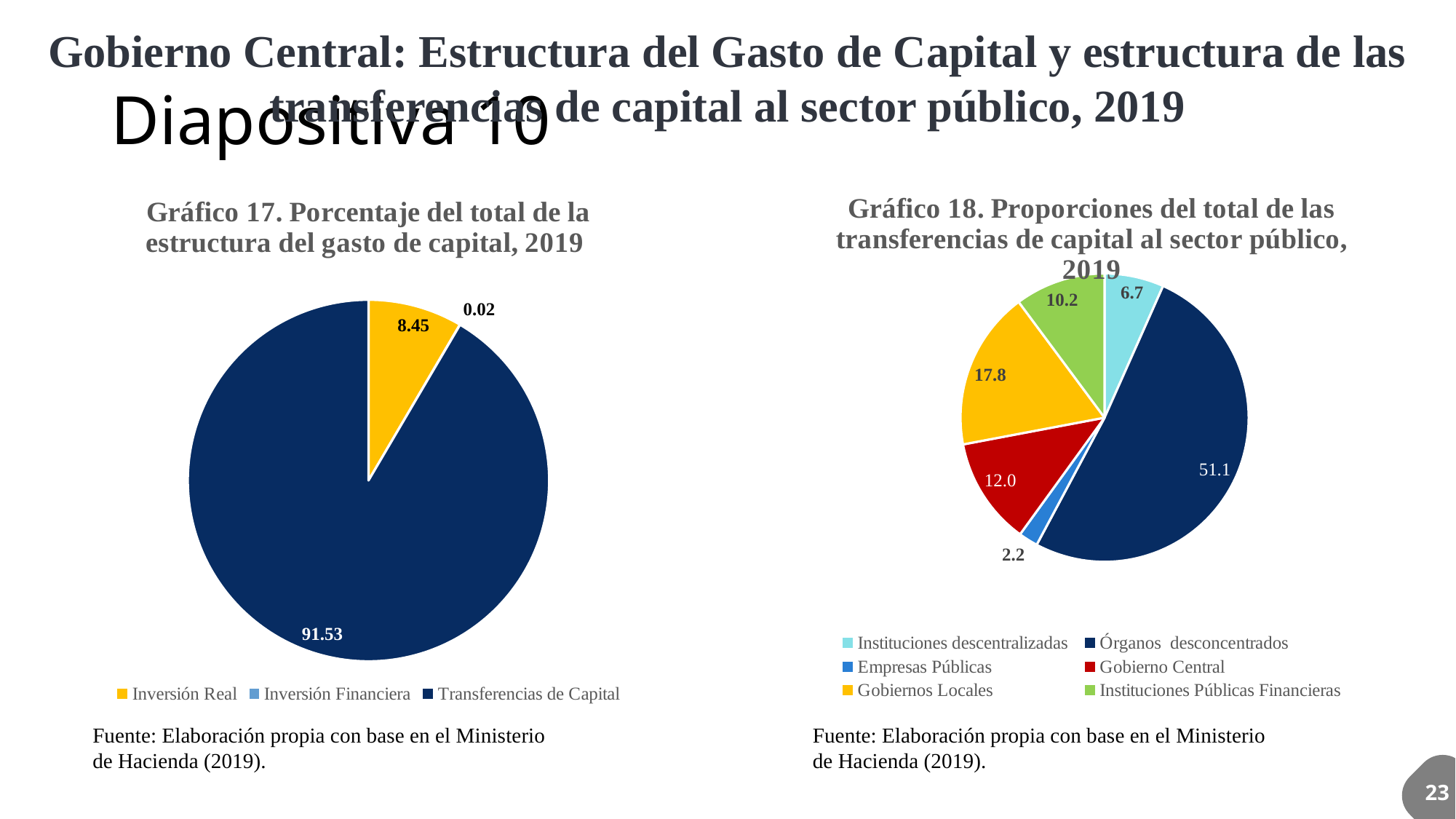
In Gráfico 17, what is the value for Transferencias de Capital? 91.53 In Gráfico 17, which category has the smallest slice? Inversión Financiera What kind of chart is Gráfico 18? Pie chart In Gráfico 18, what is the value for Empresas Públicas? 2.2 In Gráfico 18, which category has the largest slice? Órganos desconcentrados How many categories does the legend of Gráfico 17 list? 3 In Gráfico 18, what is the difference between the values for Gobiernos Locales and Instituciones descentralizadas? 11.1 In Gráfico 18, what is the value for Gobiernos Locales? 17.8 How many categories does the legend of Gráfico 18 list? 6 In Gráfico 17, what is the value for Inversión Real? 8.45 In Gráfico 18, which is larger, Gobierno Central or Instituciones Públicas Financieras? Gobierno Central In Gráfico 17, what is the difference between the values for Transferencias de Capital and Inversión Real? 83.08